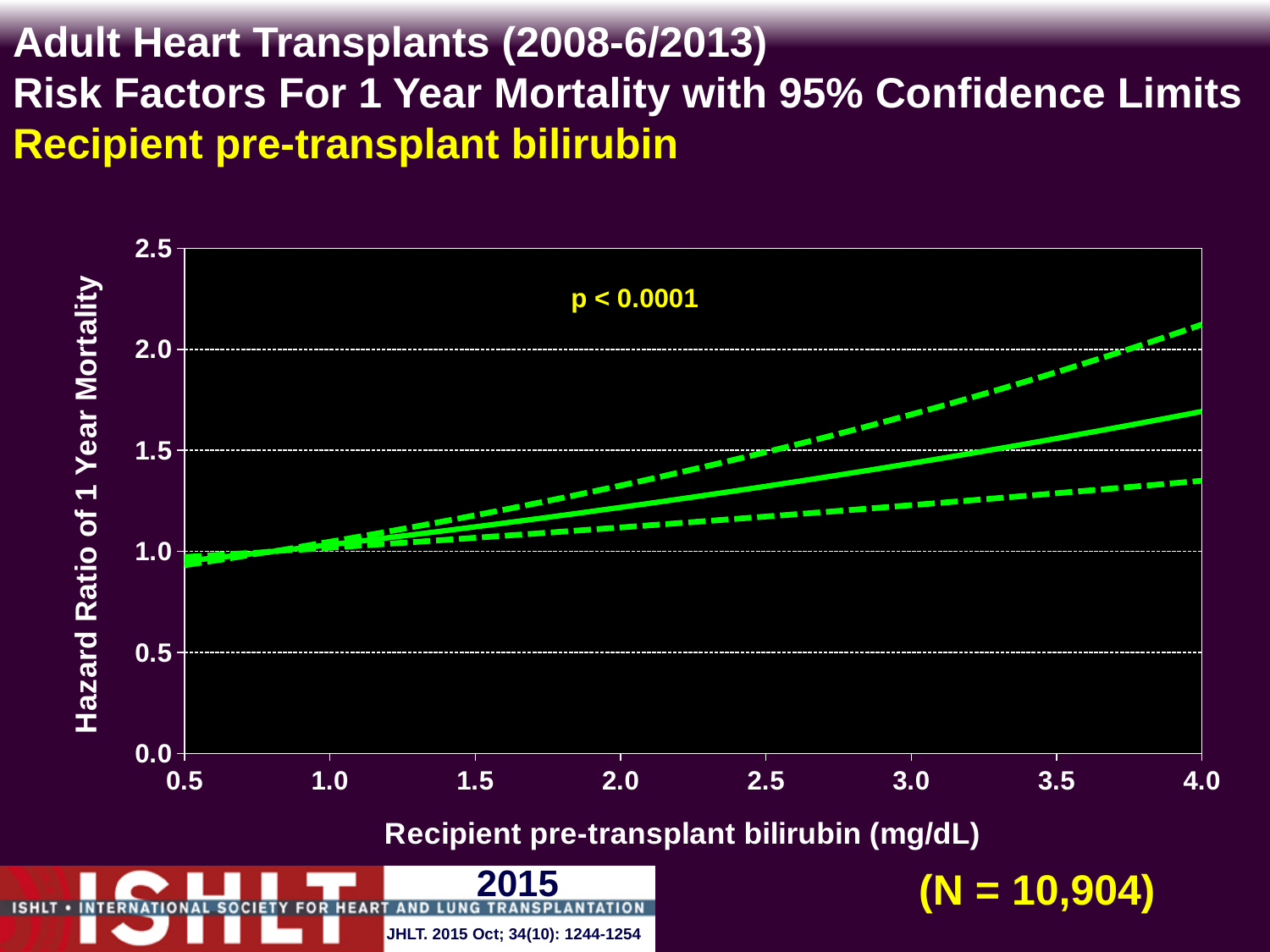
Does the hazard ratio of 1 year mortality rise or fall as recipient pre-transplant bilirubin increases? rise Is the lower 95% confidence limit (lower dashed line) at a bilirubin of 4.0 mg/dL greater or less than 1.5? less How many lines are plotted on the chart? 3 Is the hazard ratio (solid line) at a bilirubin of 2.0 mg/dL greater or less than 1.0? greater What kind of chart is shown on the slide? line chart Is the hazard ratio (solid line) at a bilirubin of 4.0 mg/dL greater or less than 1.5? greater What p-value is printed on the chart? p < 0.0001 What is the sample size (N) shown on the slide? N = 10,904